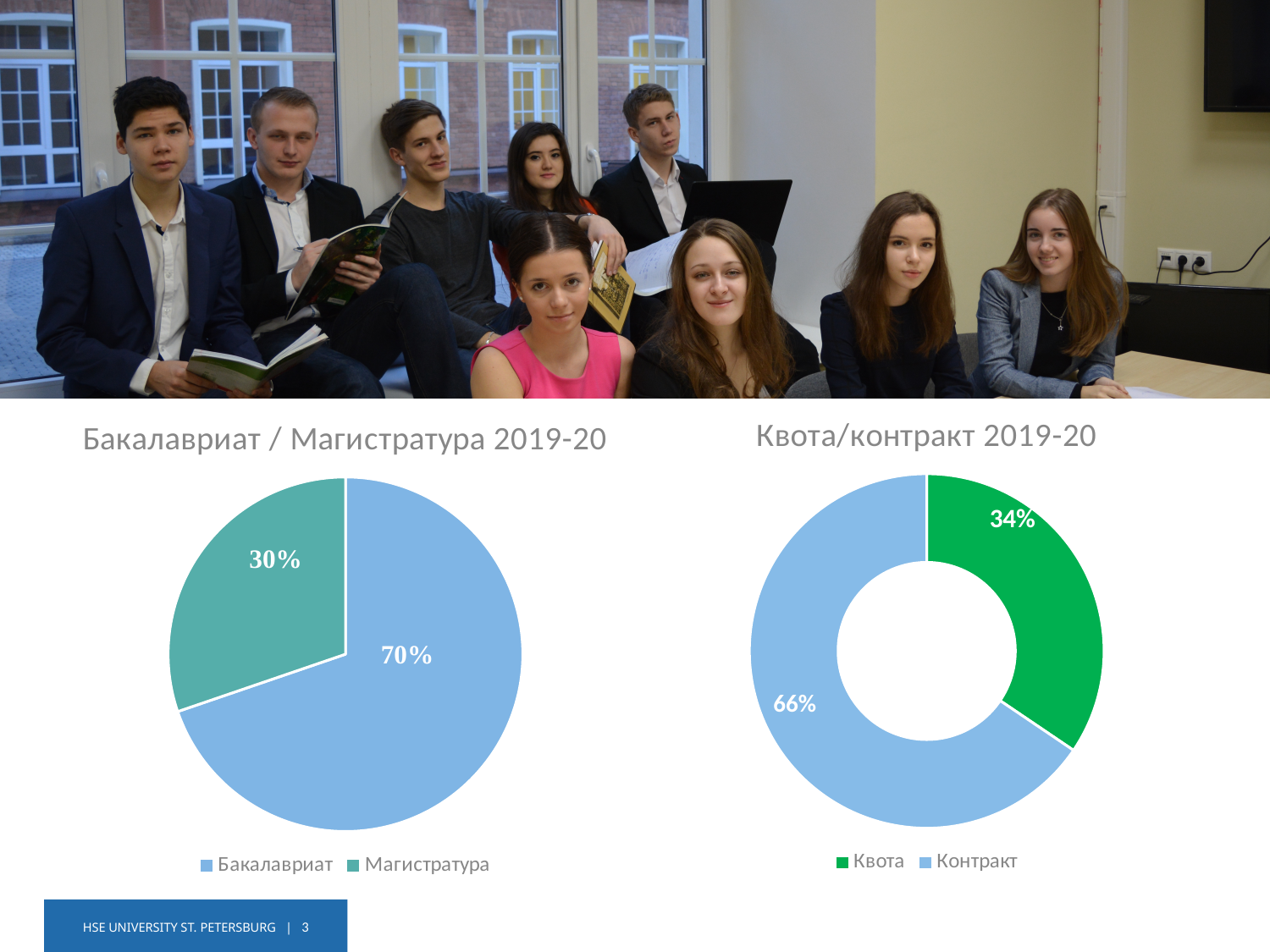
In the chart titled "Квота/контракт 2019-20", which is larger, Квота or Контракт? Контракт In the chart titled "Бакалавриат / Магистратура 2019-20", what is the difference in percentage points between Бакалавриат and Магистратура? 40 percentage points In the chart titled "Квота/контракт 2019-20", what share does Контракт have? 66% What kind of chart is the chart titled "Квота/контракт 2019-20"? Doughnut chart In the chart titled "Квота/контракт 2019-20", which category has the smallest slice? Квота How many categories does the legend of the chart titled "Бакалавриат / Магистратура 2019-20" list? 2 What colour is the Квота slice in the chart titled "Квота/контракт 2019-20"? Green In the chart titled "Бакалавриат / Магистратура 2019-20", which category has the largest slice? Бакалавриат In the chart titled "Квота/контракт 2019-20", what share does Квота have? 34% In the chart titled "Бакалавриат / Магистратура 2019-20", what share does Бакалавриат have? 70% In the chart titled "Квота/контракт 2019-20", what is the difference in percentage points between Контракт and Квота? 32 percentage points In the chart titled "Бакалавриат / Магистратура 2019-20", what share does Магистратура have? 30%